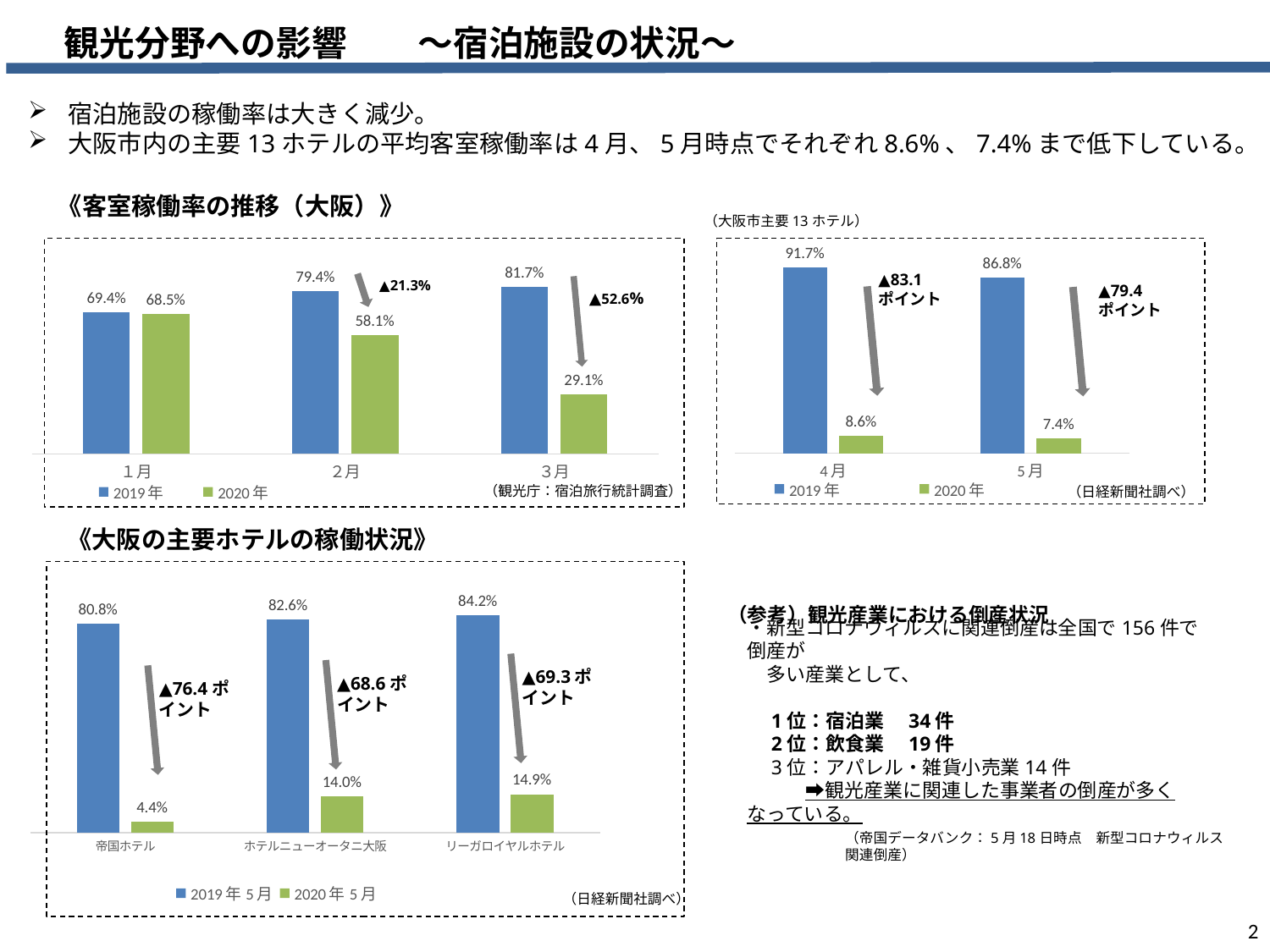
In the top-left chart 《客室稼働率の推移（大阪）》, which month has the lowest 2020年 value? 3月 In the bottom-left chart 《大阪の主要ホテルの稼働状況》, how many hotels are shown on the x axis? 3 In the top-left chart 《客室稼働率の推移（大阪）》, what is the value for 2019年 in 2月? 79.4% In the top-right chart (大阪市主要13ホテル), what is the value for 2020年 in 4月? 8.6% In the bottom-left chart 《大阪の主要ホテルの稼働状況》, what is the 2020年5月 value for 帝国ホテル? 4.4% In the bottom-left chart 《大阪の主要ホテルの稼働状況》, which hotel has the highest 2019年5月 value? リーガロイヤルホテル In the top-right chart (大阪市主要13ホテル), which is larger, the 2019年 value in 4月 or the 2019年 value in 5月? 4月 In the top-right chart (大阪市主要13ホテル), what is the value for 2019年 in 5月? 86.8% In the top-left chart 《客室稼働率の推移（大阪）》, do the 2020年 values rise or fall from 1月 to 3月? fall In the top-left chart 《客室稼働率の推移（大阪）》, what is the difference between the 2019年 and 2020年 values in 3月? 52.6% In the top-left chart 《客室稼働率の推移（大阪）》, what is the value for 2020年 in 3月? 29.1% What kind of chart is the bottom-left chart 《大阪の主要ホテルの稼働状況》? bar chart